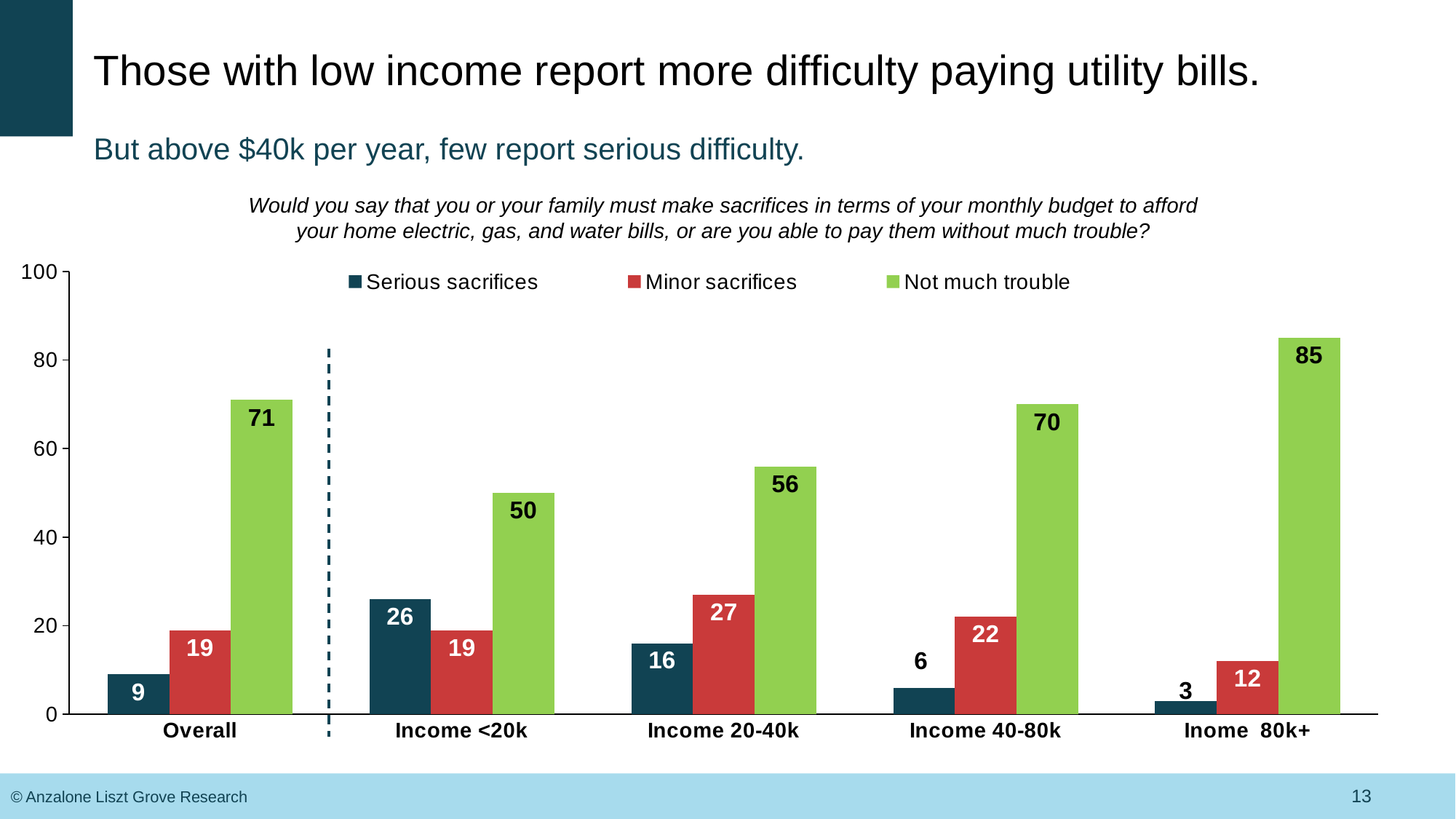
Is the value for Not much trouble in the Income 40-80k category greater or less than 60? greater What is the value for Not much trouble in the Income <20k category? 50 What is the value for Minor sacrifices in the Income 40-80k category? 22 What is the value for Serious sacrifices in the Income 20-40k category? 16 Which is larger: Minor sacrifices for Income 20-40k or Minor sacrifices for Overall? Income 20-40k How many categories are shown on the x axis? 5 How many series does the legend list? 3 Which colour represents the Minor sacrifices series? red Which category has the lowest value for Serious sacrifices? Inome 80k+ What kind of chart is shown on the slide? bar chart What is the difference between the Not much trouble values for Inome 80k+ and Income <20k? 35 Which category has the highest value for Not much trouble? Inome 80k+